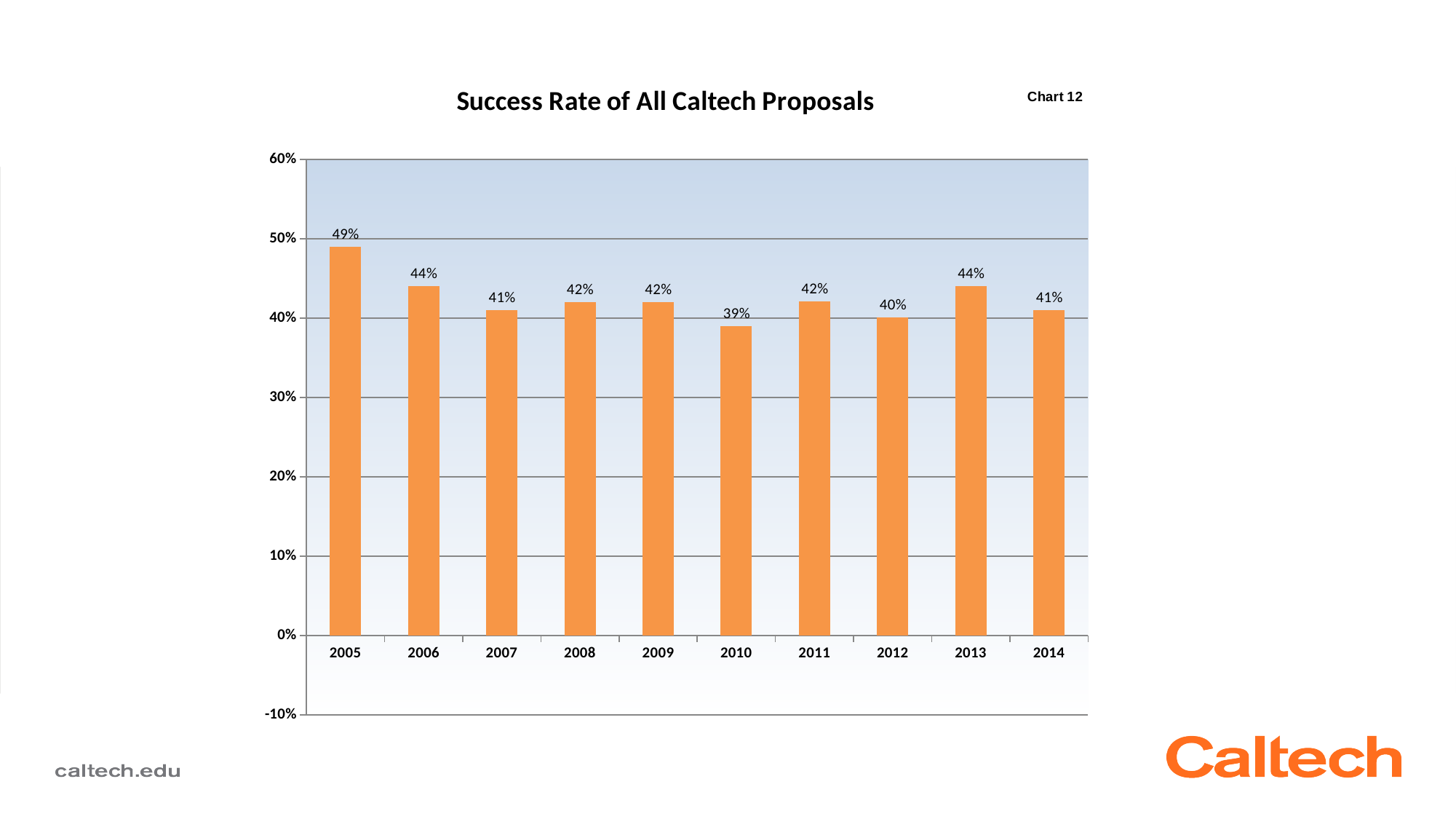
What is the difference between the success rate in 2006 and in 2014? 3% What is the success rate shown for 2010? 39% Which year has the lowest success rate? 2010 What is the title of the chart? Success Rate of All Caltech Proposals Which year has a higher success rate, 2012 or 2013? 2013 What kind of chart is shown on the slide? Bar chart What is the success rate shown for 2013? 44% Which year has the highest success rate? 2005 How many years are shown on the x axis? 10 Is the success rate for 2010 greater or less than 40%? less What is the difference between the success rate in 2005 and in 2010? 10% What is the success rate of all Caltech proposals in 2005? 49%